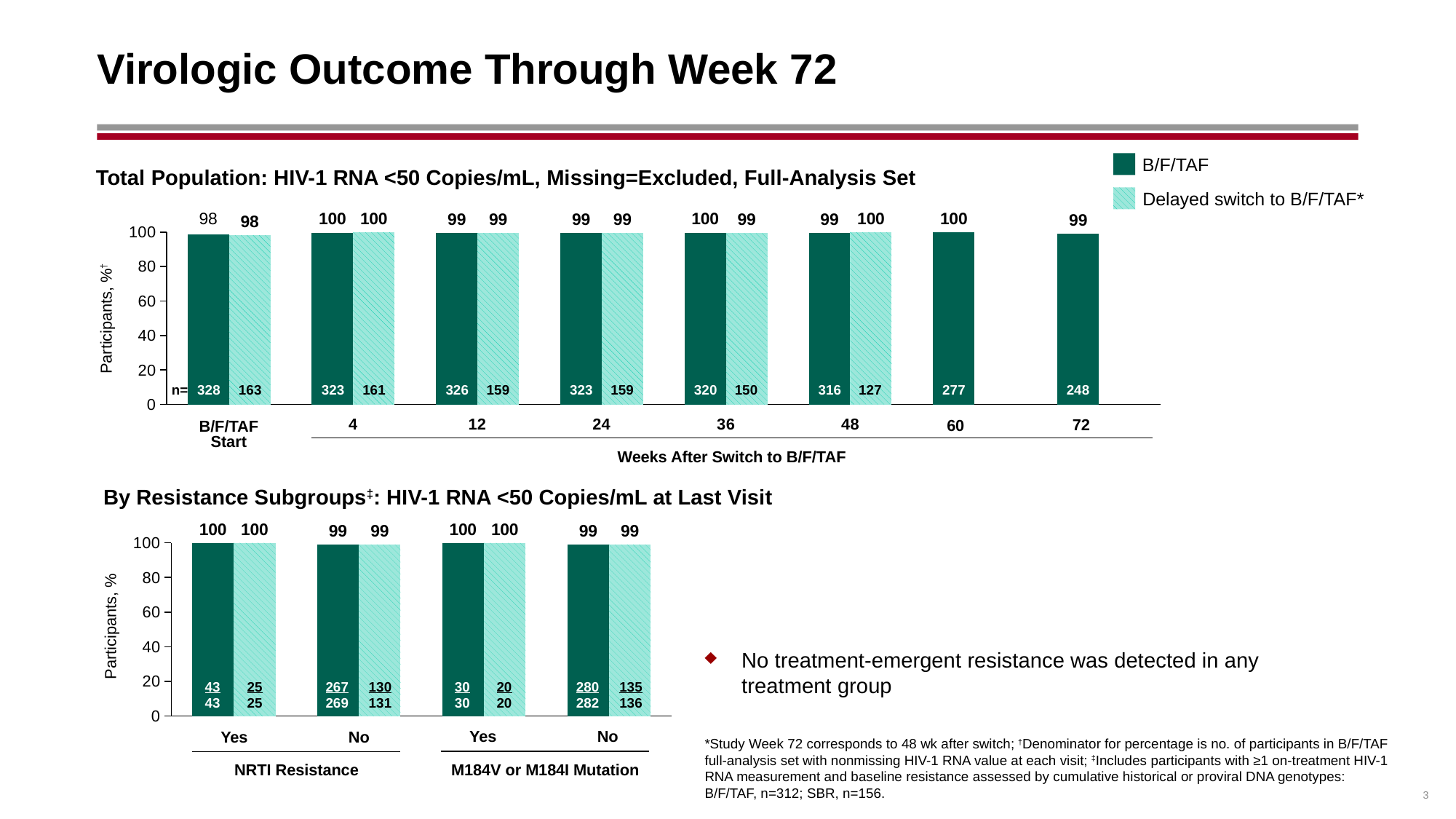
In the top chart (Total Population), what is the value for Delayed switch to B/F/TAF at week 48? 100 What kind of chart is the top chart (Total Population)? Bar chart In the bottom chart (By Resistance Subgroups), how many subgroup categories are shown on the x axis? 4 In the top chart (Total Population), what is the value for B/F/TAF at week 36 after switch? 100 In the bottom chart (By Resistance Subgroups), what is the value for B/F/TAF in the NRTI Resistance 'No' group? 99 In the top chart (Total Population), how many time points are shown along the x axis? 8 In the top chart (Total Population), is the value for B/F/TAF at B/F/TAF Start greater or less than 80? greater In the top chart (Total Population), what is the difference between the B/F/TAF value and the Delayed switch value at week 36? 1 In the top chart (Total Population), what is the n for the Delayed switch to B/F/TAF bar at week 4? 161 How many series does the legend list for the charts on this slide? 2 In the top chart (Total Population), what is the value for B/F/TAF at week 72? 99 In the bottom chart (By Resistance Subgroups), what is the value for Delayed switch to B/F/TAF in the M184V or M184I Mutation 'Yes' group? 100